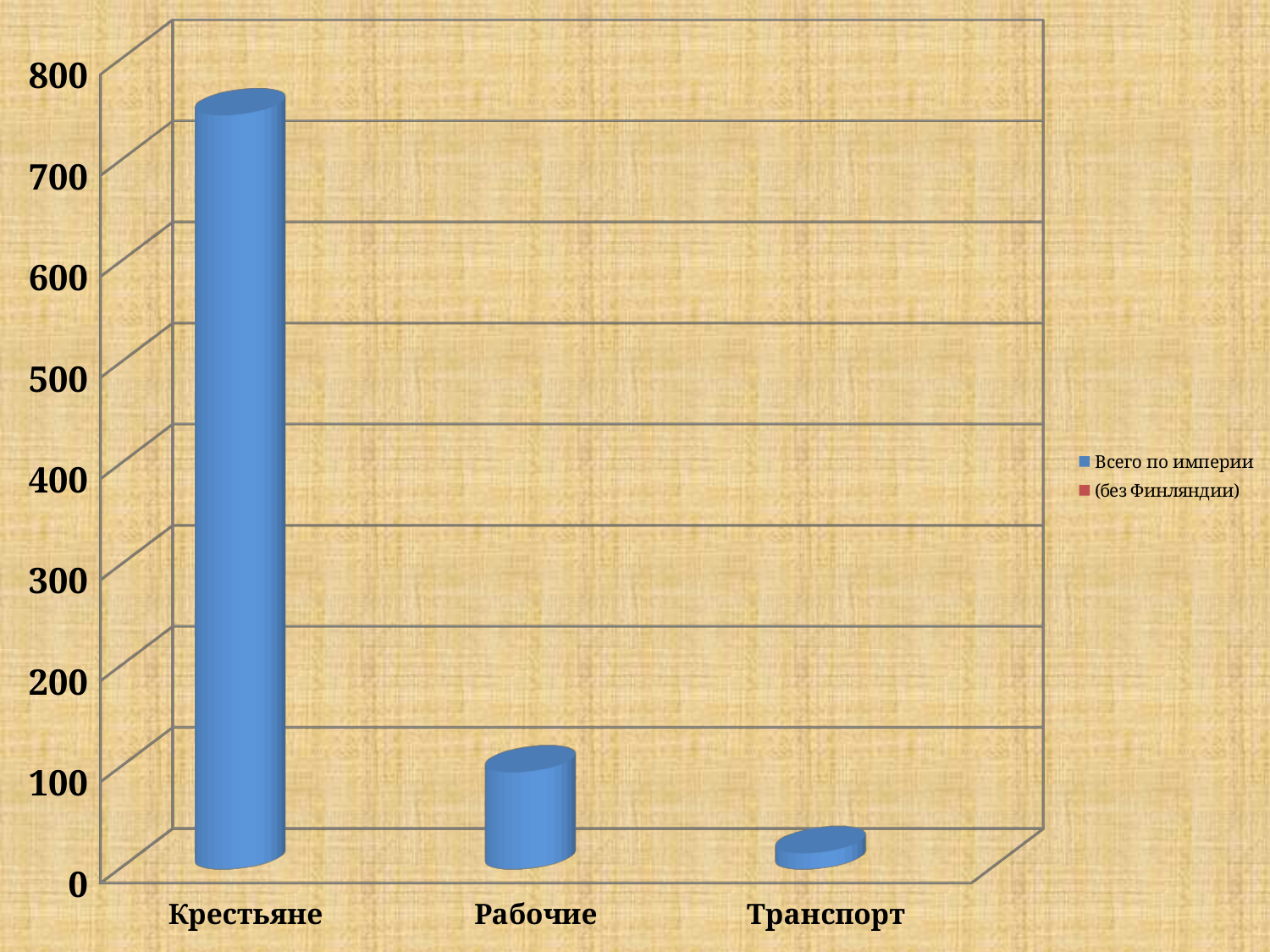
Which is larger, the value for Рабочие or the value for Транспорт? Рабочие How many categories are shown on the x axis of the chart? 3 Do the bar values rise or fall from left to right along the x axis? fall Is the value for Транспорт greater or less than 100? less Is the value for Крестьяне greater or less than 700? greater What is the first series name listed in the chart legend? Всего по империи What kind of chart is shown on the slide? bar chart Is the value for Рабочие greater or less than 200? less How many series does the chart legend list? 2 What colour are the bars in the chart? blue Which category has the lowest bar in the chart? Транспорт Which category has the highest bar in the chart? Крестьяне